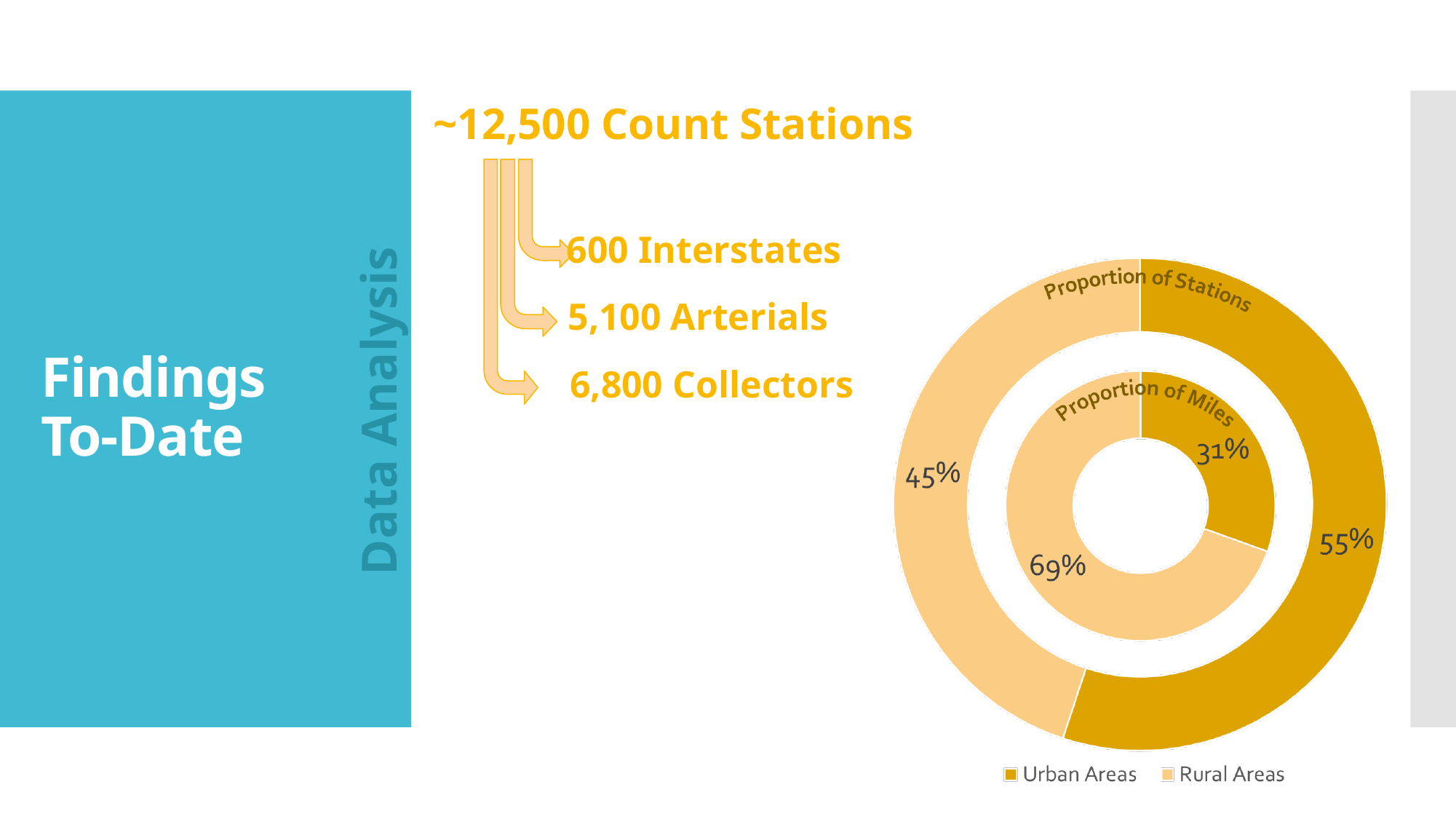
What kind of chart is shown on the slide? Doughnut chart In the Proportion of Miles ring, which category has the smaller share? Urban Areas What is the difference between the Rural Areas share of miles and the Rural Areas share of stations? 24% How many series does the chart legend list? 2 Is the Urban Areas share larger in the Proportion of Stations ring or the Proportion of Miles ring? Proportion of Stations In the Proportion of Stations ring, what share is Urban Areas? 55% In the Proportion of Miles ring, what share is Urban Areas? 31% Which legend entry is shown in the darker gold colour? Urban Areas What are the two rings of the doughnut chart labelled? Proportion of Stations and Proportion of Miles In the Proportion of Miles ring, what share is Rural Areas? 69% In the Proportion of Stations ring, which category has the larger share? Urban Areas In the Proportion of Stations ring, what share is Rural Areas? 45%